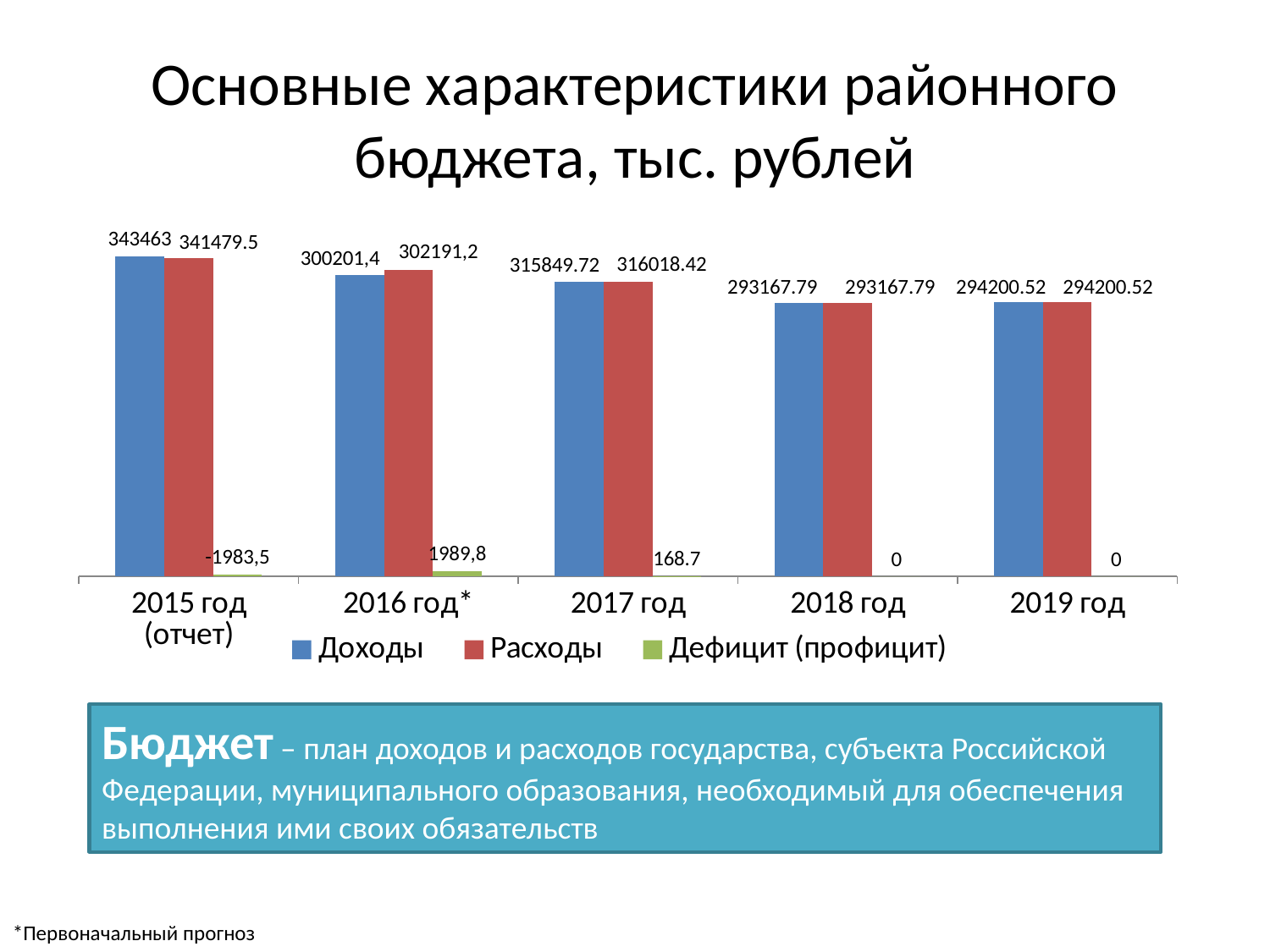
What is the value of Доходы for 2015 год (отчет)? 343463 How many series does the legend list? 3 What is the value of Дефицит (профицит) for 2017 год? 168.7 What kind of chart is shown on the slide? Bar chart For 2016 год*, which is larger, Доходы or Расходы? Расходы Does Доходы rise or fall from 2015 год (отчет) to 2016 год*? Fall In which year is Расходы the lowest? 2018 год In which year is Доходы the highest? 2015 год (отчет) How many years are shown on the x axis? 5 What is the difference between Доходы and Расходы for 2015 год (отчет)? 1983.5 What is the value of Расходы for 2016 год*? 302191,2 What is the value of Доходы for 2019 год? 294200.52